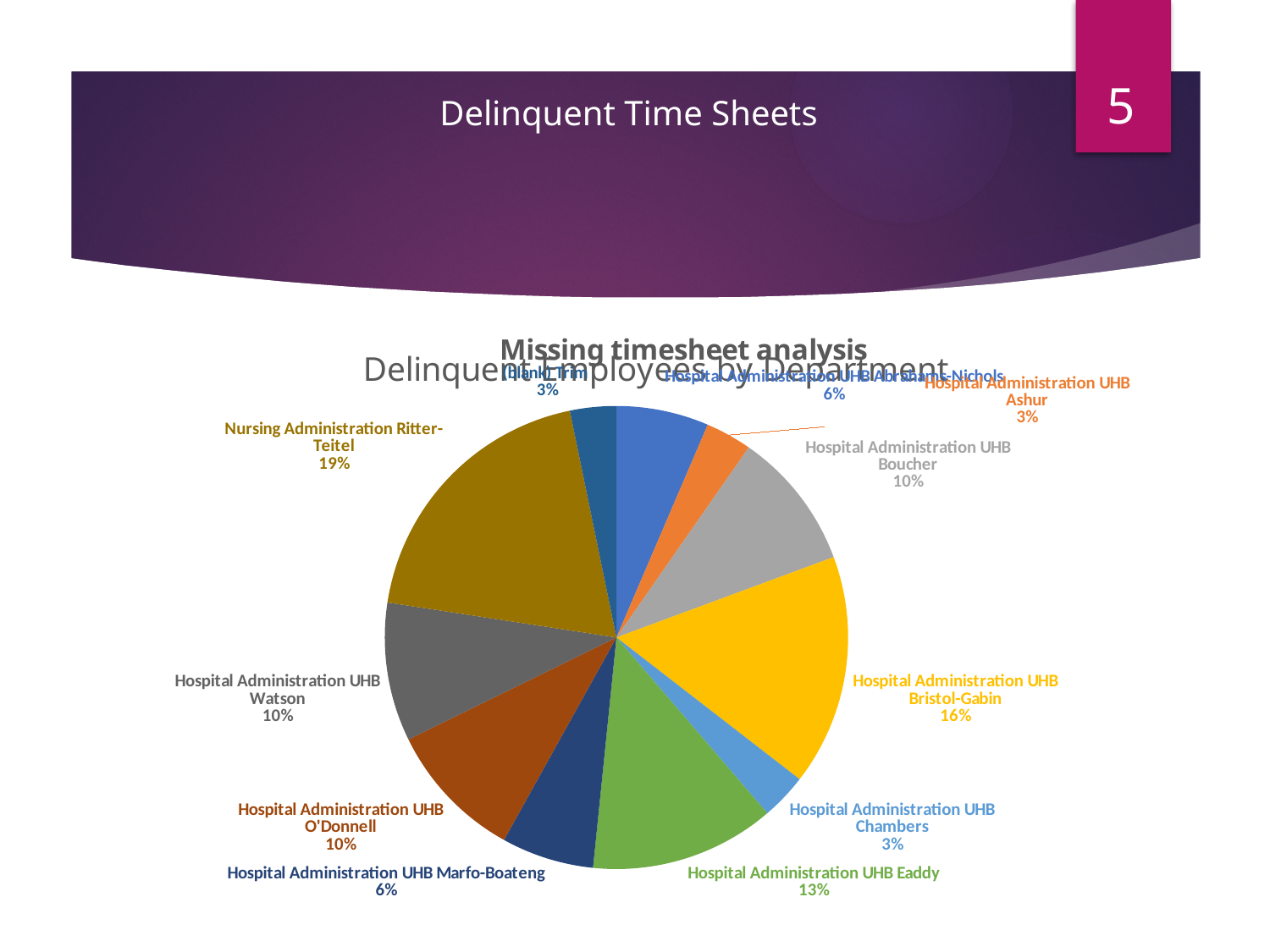
What share of the pie does Nursing Administration Ritter-Teitel account for? 19% What is the value shown for Hospital Administration UHB Boucher? 10% How many slices does the pie chart have? 11 What is the value shown for Hospital Administration UHB Chambers? 3% What is the difference in percentage points between Nursing Administration Ritter-Teitel and Hospital Administration UHB Bristol-Gabin? 3 percentage points What is the value shown for Hospital Administration UHB Eaddy? 13% What is the bold title printed above the pie chart? Missing timesheet analysis What is the value shown for Hospital Administration UHB Marfo-Boateng? 6% Which slice is the largest in the pie chart? Nursing Administration Ritter-Teitel What share of the pie does Hospital Administration UHB Bristol-Gabin account for? 16% What kind of chart is shown on the slide? pie chart Which is larger, the slice for Hospital Administration UHB Eaddy or the slice for Hospital Administration UHB Watson? Hospital Administration UHB Eaddy